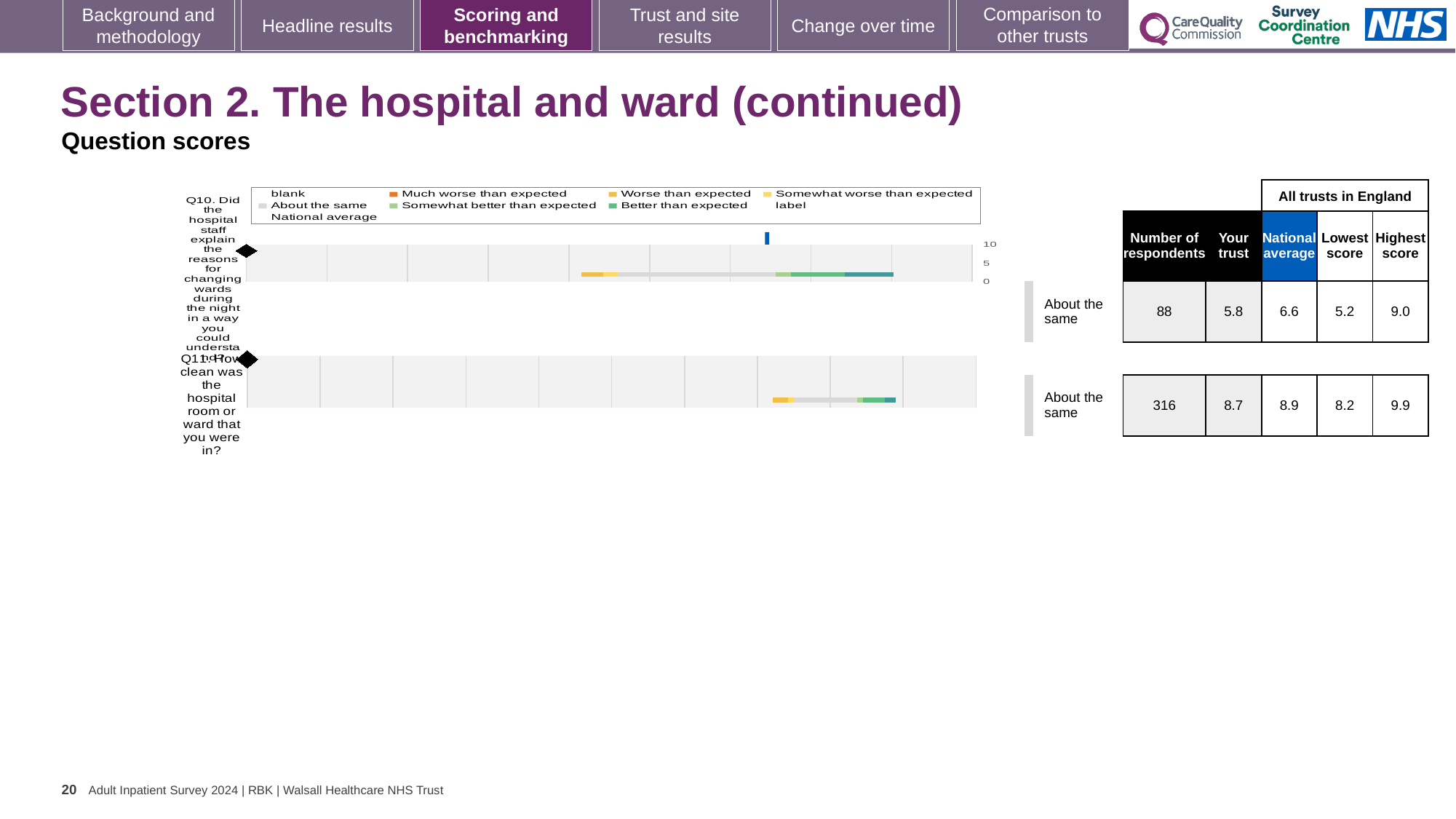
Which question has more respondents, Q10 or Q11? Q11 How many respondents are shown for Q11 (how clean was the hospital room or ward)? 316 For Q11 (how clean was the hospital room or ward), which is larger: the 'Your trust' score or the national average? National average What is the lowest score among all trusts in England for Q11 (how clean was the hospital room or ward)? 8.2 For Q10 (explaining reasons for changing wards during the night), how many respondents are shown? 88 What is the 'Your trust' score for Q11 (how clean was the hospital room or ward)? 8.7 What is the difference between the highest score and the lowest score for Q10 (explaining reasons for changing wards during the night)? 3.8 How many questions are plotted on this slide? 2 What benchmark category is shown for Q10 (explaining reasons for changing wards during the night)? About the same What is the highest score among all trusts in England for Q10 (explaining reasons for changing wards during the night)? 9.0 What is the 'Your trust' score for Q10 (explaining reasons for changing wards during the night)? 5.8 What is the national average score for Q10 (explaining reasons for changing wards during the night)? 6.6